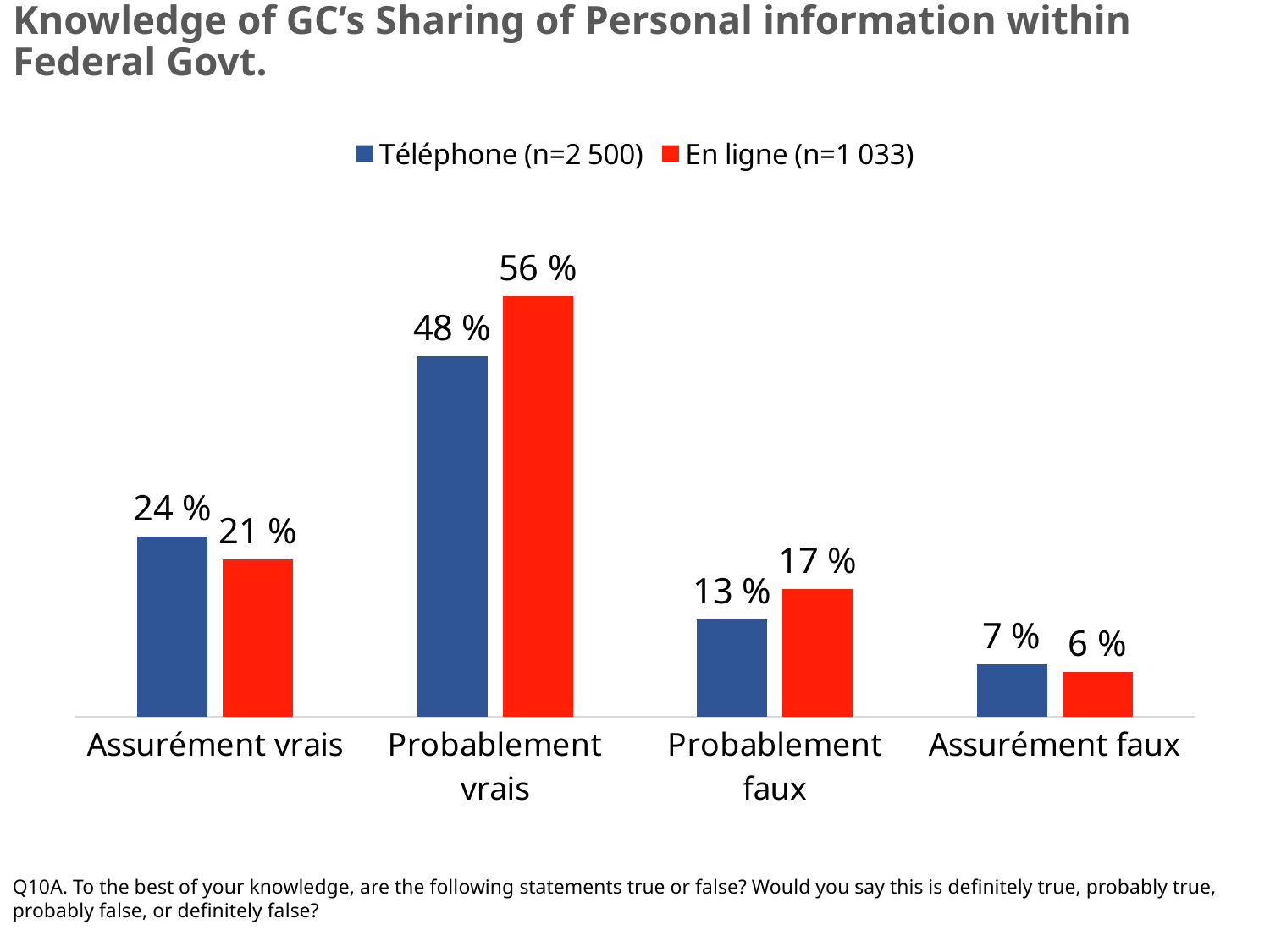
Which category has the lowest Téléphone (n=2 500) value? Assurément faux For Probablement faux, which series has the larger value, Téléphone (n=2 500) or En ligne (n=1 033)? En ligne (n=1 033) What kind of chart is shown on the slide? Bar chart How many categories are shown on the x axis? 4 What colour are the En ligne (n=1 033) bars? Red What is the En ligne (n=1 033) value for Probablement faux? 17 % What is the difference between the En ligne (n=1 033) and Téléphone (n=2 500) values for Probablement vrais? 8 % What is the difference between the Téléphone (n=2 500) and En ligne (n=1 033) values for Assurément vrais? 3 % Which category has the highest En ligne (n=1 033) value? Probablement vrais How many series does the legend list? 2 What is the Téléphone (n=2 500) value for Probablement vrais? 48 % What is the En ligne (n=1 033) value for Assurément faux? 6 %